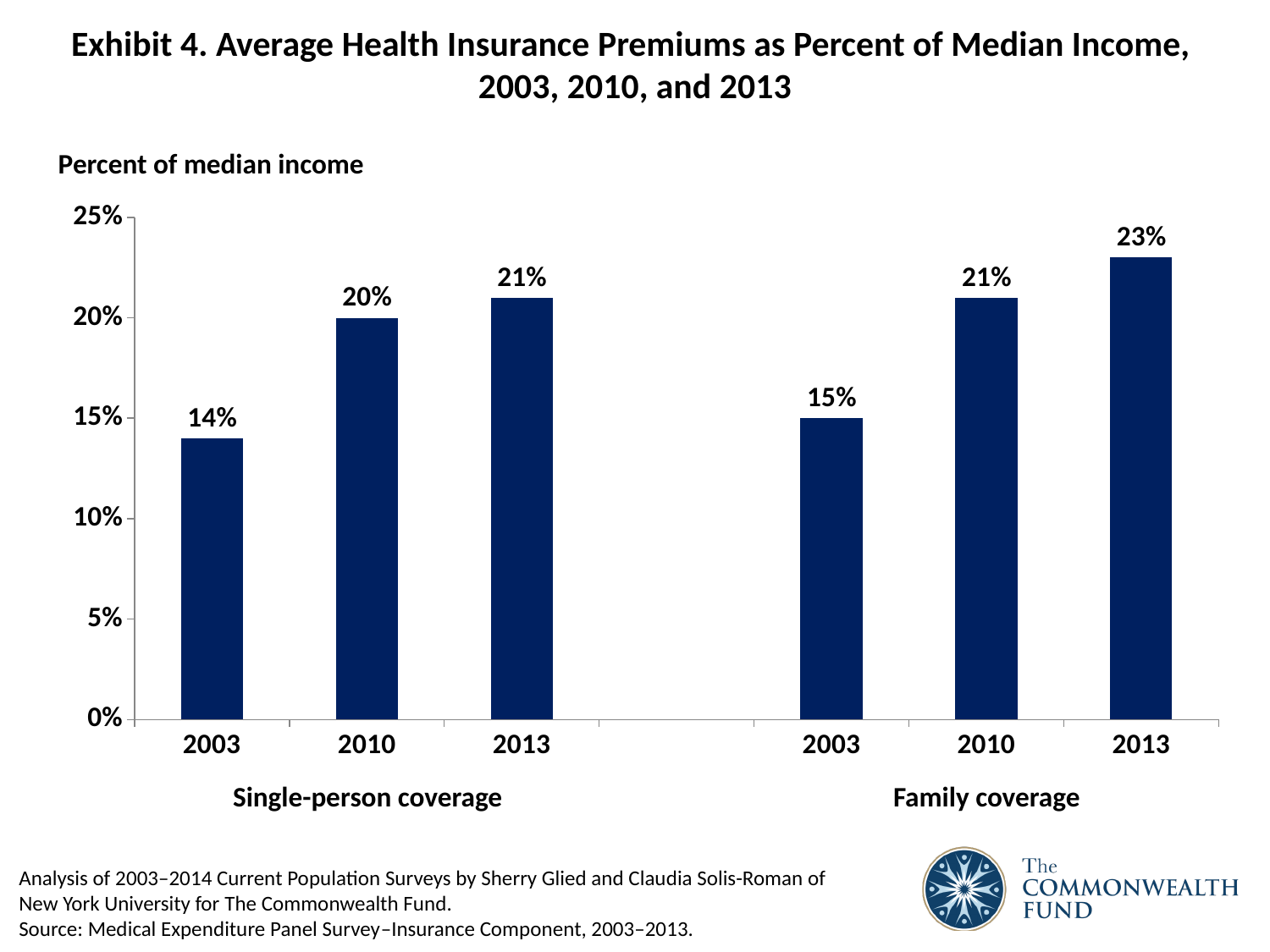
What is the value for family coverage in 2003? 15% What is the difference between family coverage in 2013 and family coverage in 2003? 8% What kind of chart is shown on the slide? Bar chart What is the difference between single-person coverage in 2013 and single-person coverage in 2003? 7% What is the value for family coverage in 2013? 23% How many bars are plotted on the chart? 6 Do the values for family coverage rise or fall from 2003 to 2013? Rise Which is larger: single-person coverage in 2013 or family coverage in 2013? Family coverage in 2013 Which bar has the highest value on the chart? Family coverage, 2013 What is the value for single-person coverage in 2010? 20% Which bar has the lowest value on the chart? Single-person coverage, 2003 What is the value for single-person coverage in 2003? 14%